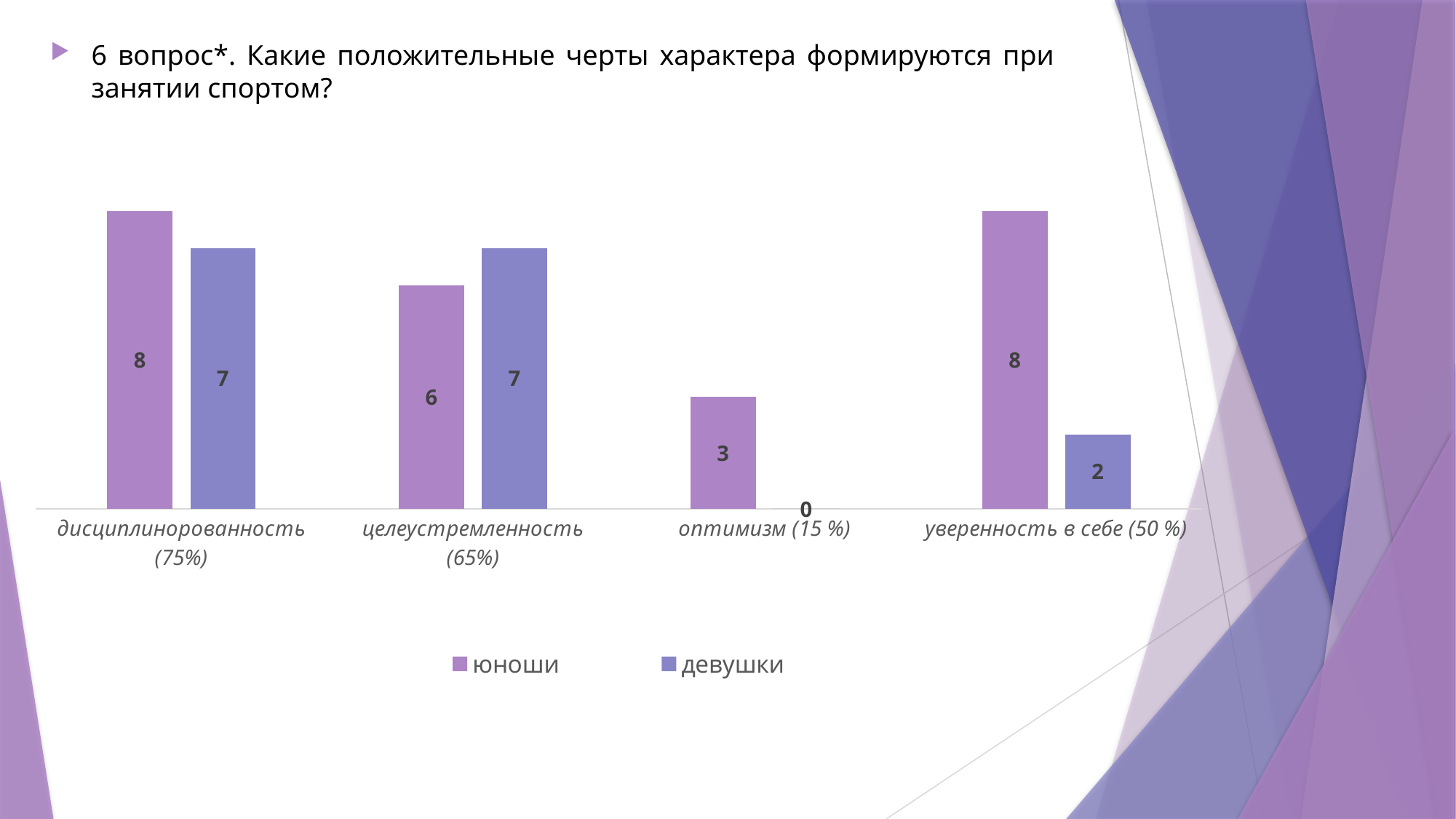
What is the difference between the юноши and девушки values in the category уверенность в себе (50 %)? 6 What are the two series names listed in the legend? юноши and девушки What is the value for юноши in the category уверенность в себе (50 %)? 8 Which category has the lowest value for юноши? оптимизм (15 %) Which category has the lowest value for девушки? оптимизм (15 %) What is the value for юноши in the category дисциплинированность (75%)? 8 How many series does the legend list? 2 How many categories are shown on the x axis? 4 In the category целеустремленность (65%), which series has the larger value, юноши or девушки? девушки What is the value for девушки in the category целеустремленность (65%)? 7 What is the value for девушки in the category оптимизм (15 %)? 0 What kind of chart is shown on the slide? bar chart